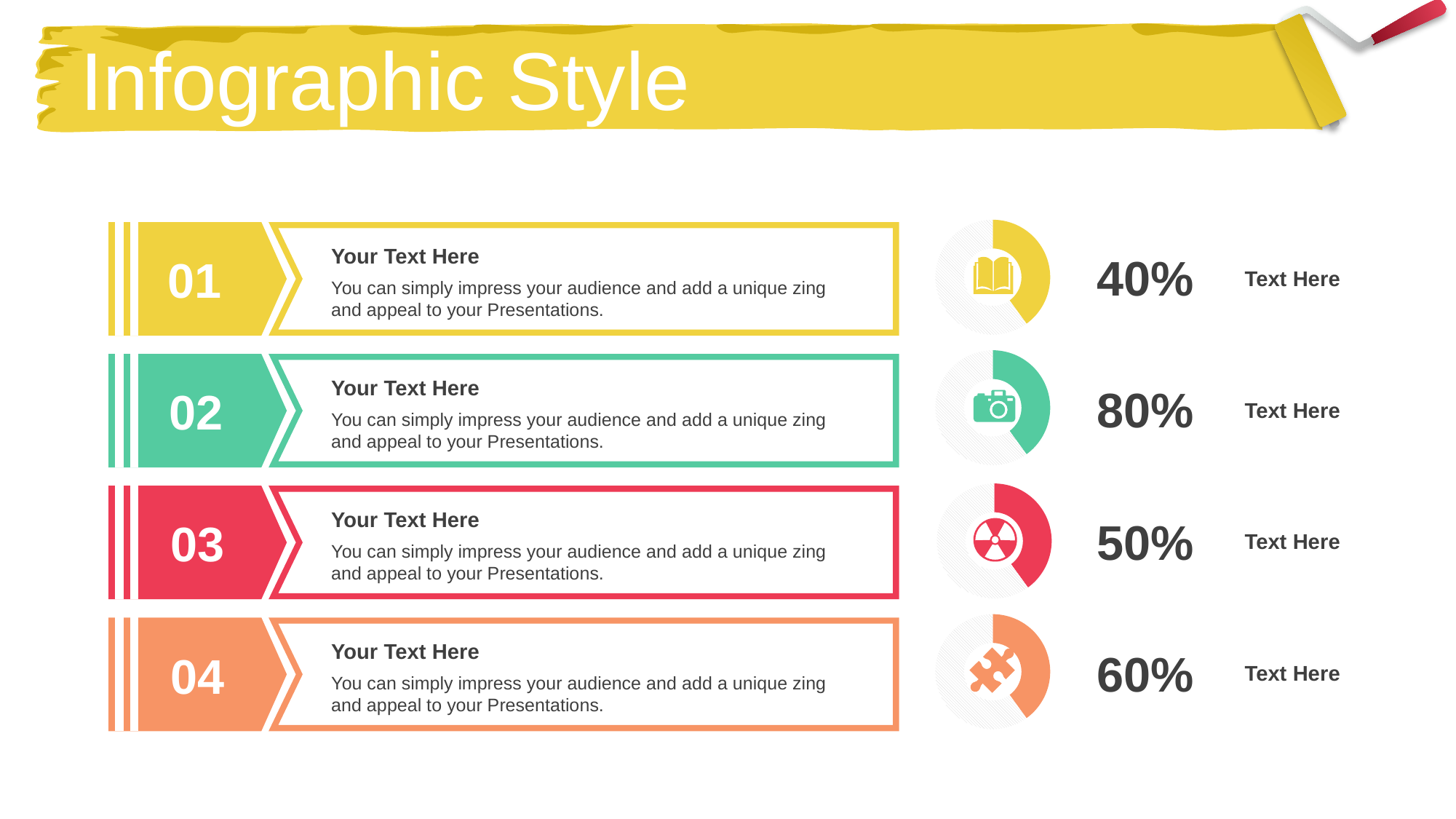
What percentage is shown next to the second (green) circular chart, in the row labelled 02? 80% What colour is the filled portion of the circular chart in the row labelled 03? Red What percentage is shown next to the first (yellow) circular chart at the top right? 40% What percentage is shown next to the fourth (orange) circular chart, in the row labelled 04? 60% What is the difference between the percentage in row 02 and the percentage in row 01? 40% How many circular percentage charts are on the slide? 4 What percentage is shown next to the third (red) circular chart, in the row labelled 03? 50% Which is larger, the percentage for row 03 or the percentage for row 04? Row 04 (60%) What kind of chart is used to show the percentages on the right side of the slide? Pie (doughnut) chart Which row's circular chart shows the highest percentage? 02 (80%) What is the difference between the percentage in row 04 and the percentage in row 03? 10% Which row's circular chart shows the lowest percentage? 01 (40%)